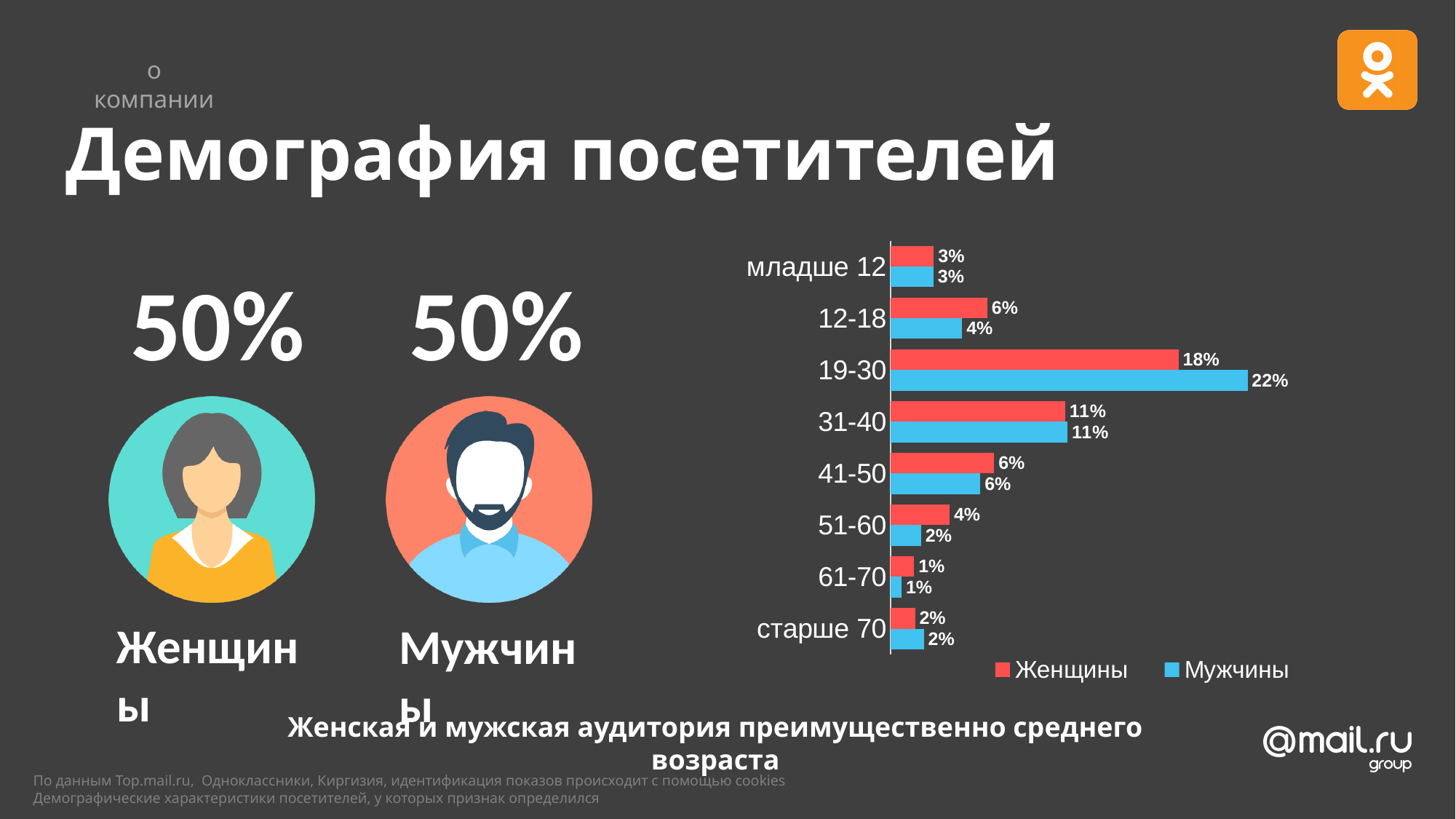
How many age groups are shown in the bar chart? 8 What kind of chart is shown on the slide? Bar chart Which age group has the lowest value for Женщины? 61-70 Which age group has the highest value for Мужчины? 19-30 What is the value for Мужчины in the 12-18 age group? 4% Which colour represents Мужчины in the chart? Blue What is the value for Мужчины in the 19-30 age group? 22% What is the difference between the Мужчины and Женщины values in the 19-30 age group? 4% What is the value for Женщины in the 19-30 age group? 18% What is the value for Женщины in the 51-60 age group? 4% In the 51-60 age group, which is larger: Женщины or Мужчины? Женщины How many series does the legend list? 2